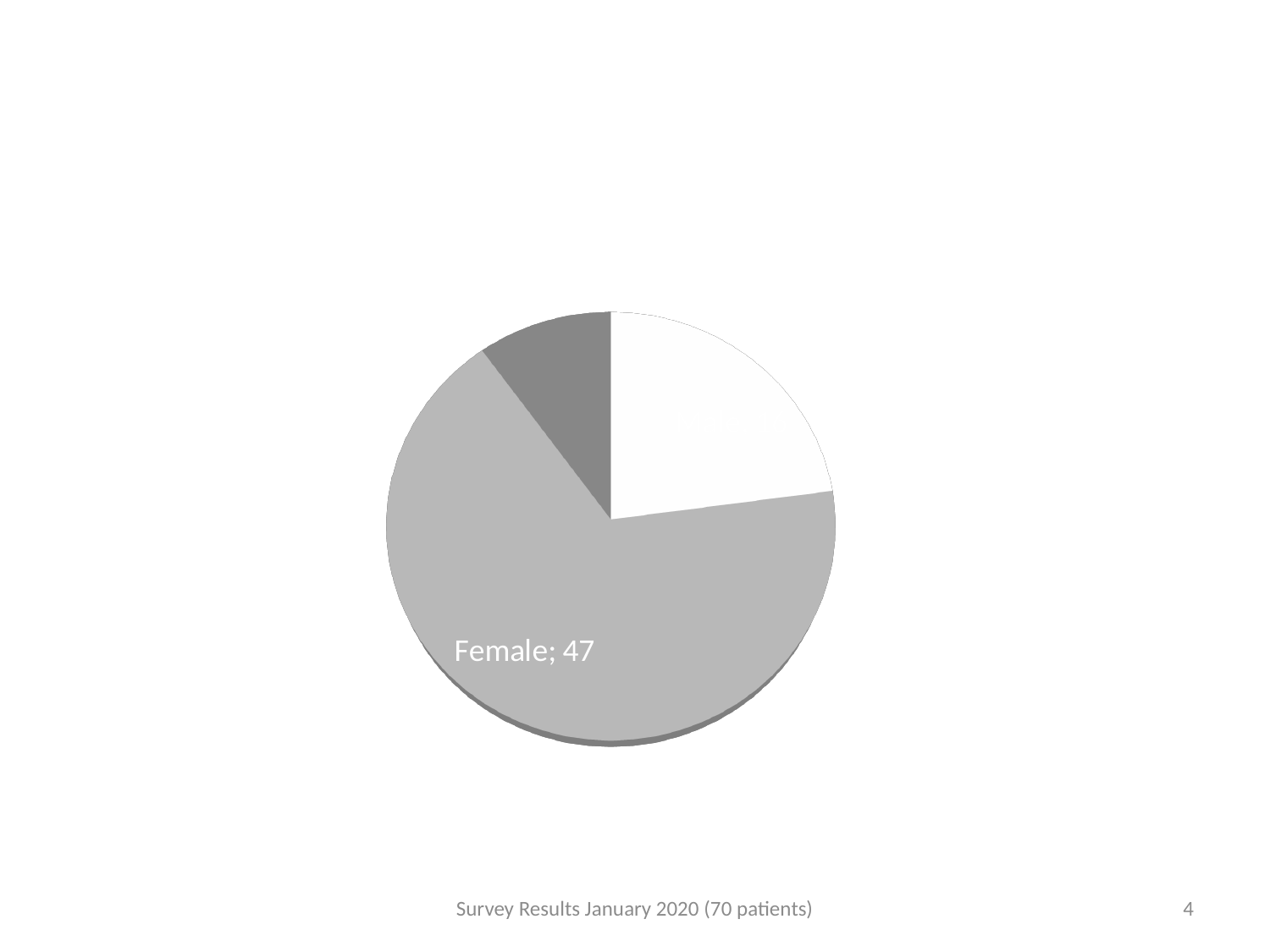
How many slices does the pie chart have? 3 Does the Female slice take up more or less than half of the pie? more Which slice of the pie chart is the largest? Female What colour is the Female slice of the pie chart? grey What is the value shown for the Female slice of the pie chart? 47 How many slices of the pie chart have a data label? 1 What kind of chart is shown on the slide? pie chart